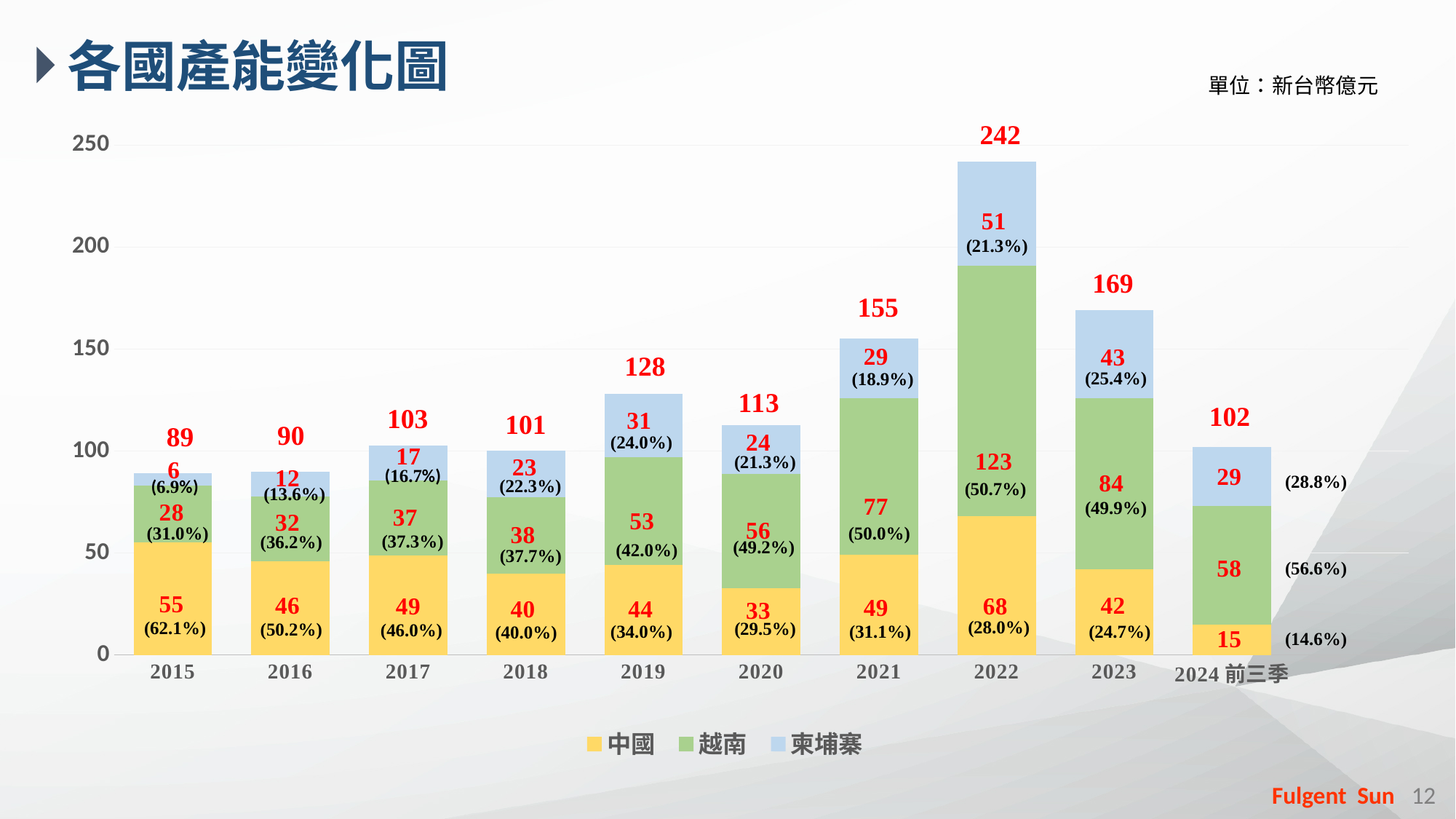
What is the value for 中國 in 2015? 55 Which year has the lowest total? 2015 Which is larger, the 中國 value in 2021 or the 中國 value in 2022? 2022 How many series does the legend list? 3 What is the value for 柬埔寨 in 2023? 43 How many categories are shown on the x axis? 10 What type of chart is shown on the slide? Stacked bar chart Which year has the highest total? 2022 What percentage share does 柬埔寨 have in 2024 前三季? 28.8% What is the total of the stacked bar for 2019? 128 What is the difference between the totals for 2022 and 2023? 73 What is the value for 越南 in 2022? 123